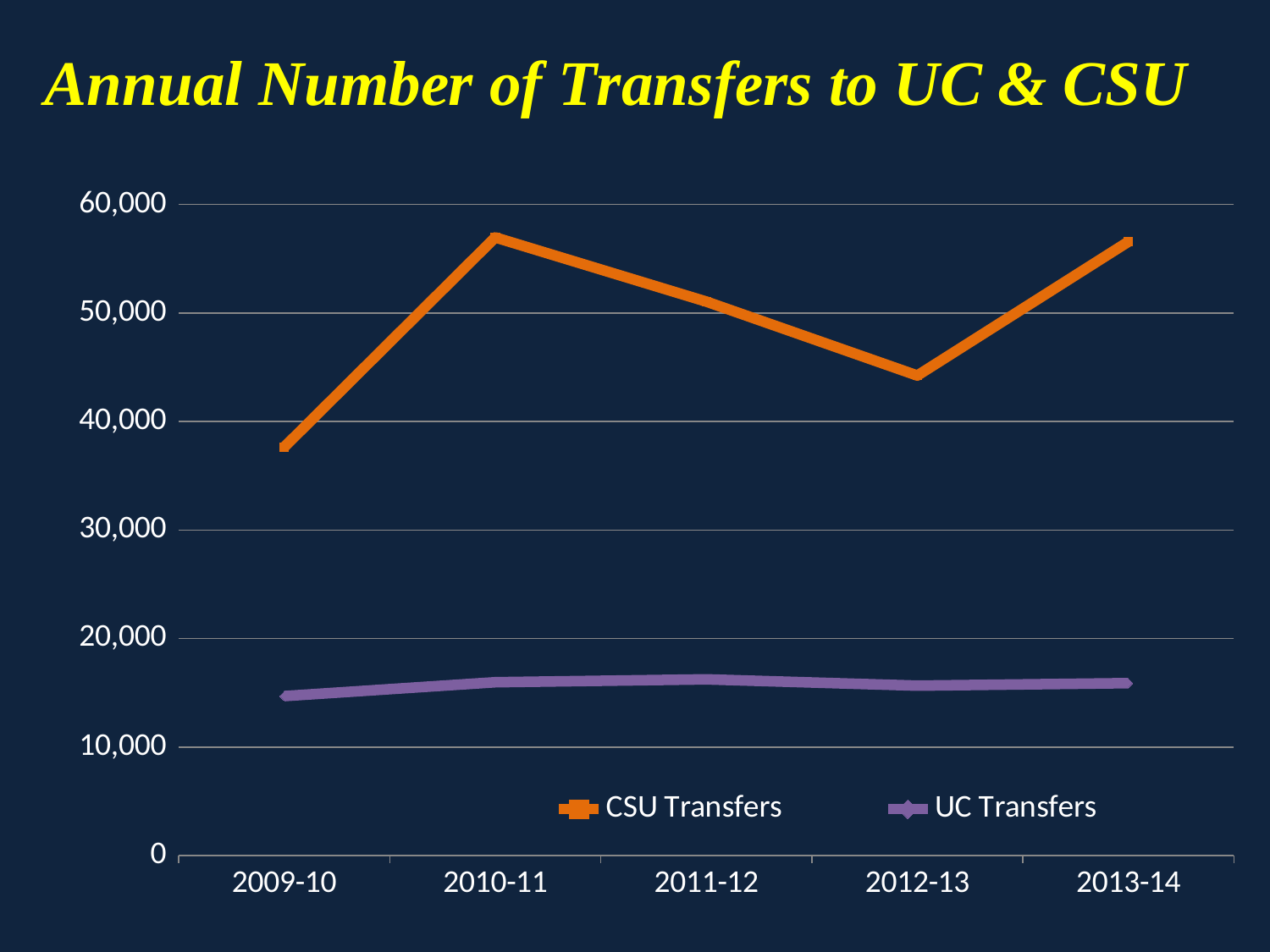
What is the title of the chart? Annual Number of Transfers to UC & CSU In which year is the CSU Transfers value lowest? 2009-10 How many academic years are plotted along the x axis? 5 What kind of chart is shown on the slide? Line chart How many series does the legend list? 2 Do CSU Transfers rise or fall from 2010-11 to 2012-13? Fall Is the CSU Transfers value for 2010-11 greater or less than 50,000? greater Is the CSU Transfers value for 2009-10 greater or less than 40,000? less Which colour represents UC Transfers in the legend? Purple Which series has the larger value in 2013-14, CSU Transfers or UC Transfers? CSU Transfers Is the UC Transfers value for 2011-12 greater or less than 20,000? less